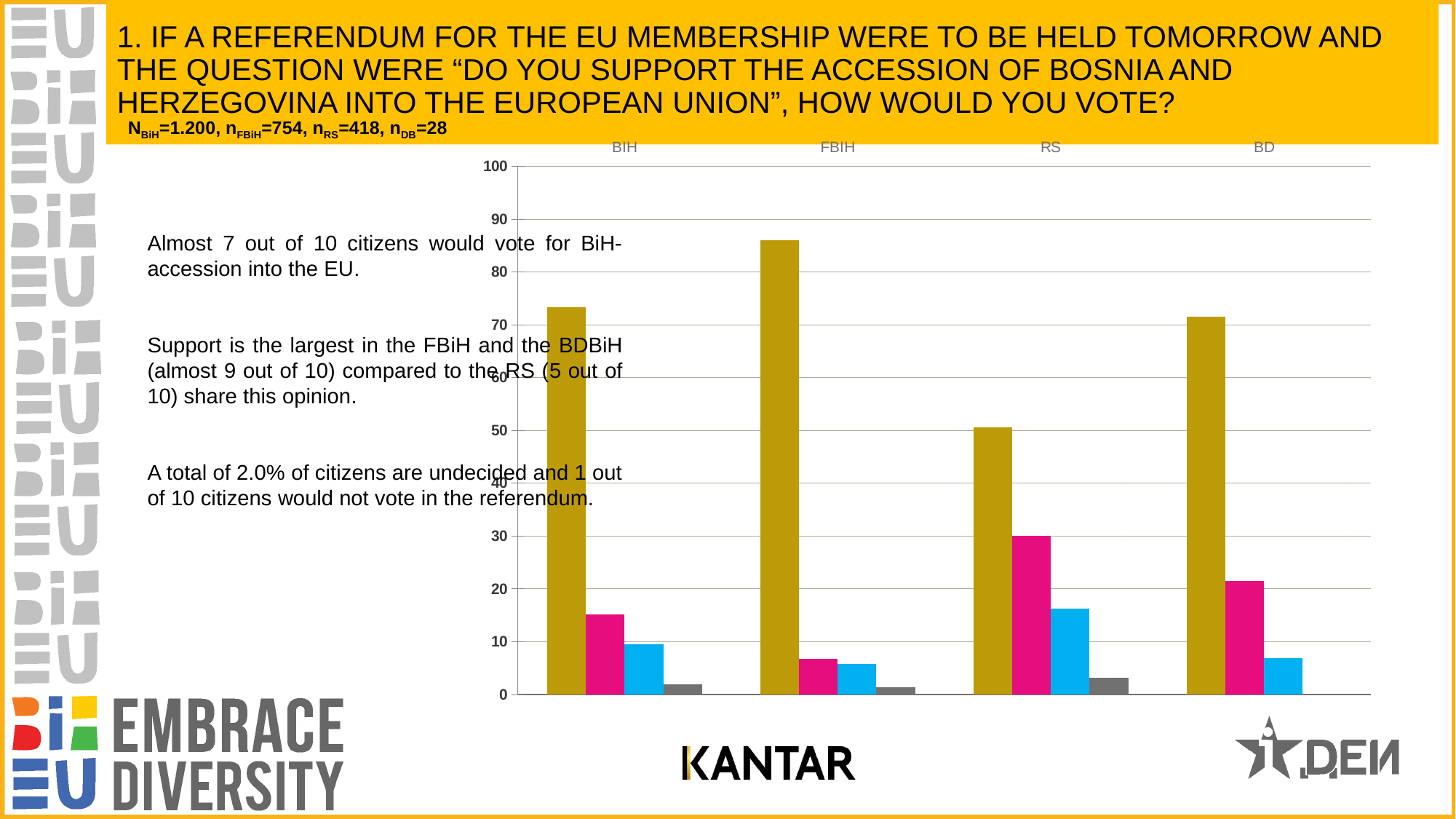
Is the magenta bar for RS greater or less than 20? greater Which category has the tallest magenta bar? RS How many categories are shown along the x axis of the chart? 4 Is the gold bar for RS greater or less than 60? less Is the gold bar for FBIH greater or less than 80? greater Which is larger, the magenta bar for BD or the magenta bar for BIH? BD What kind of chart is shown on the slide? bar chart Which category has the shortest gold bar? RS Which category has the tallest gold bar? FBIH Which is larger, the blue bar for BIH or the blue bar for FBIH? BIH